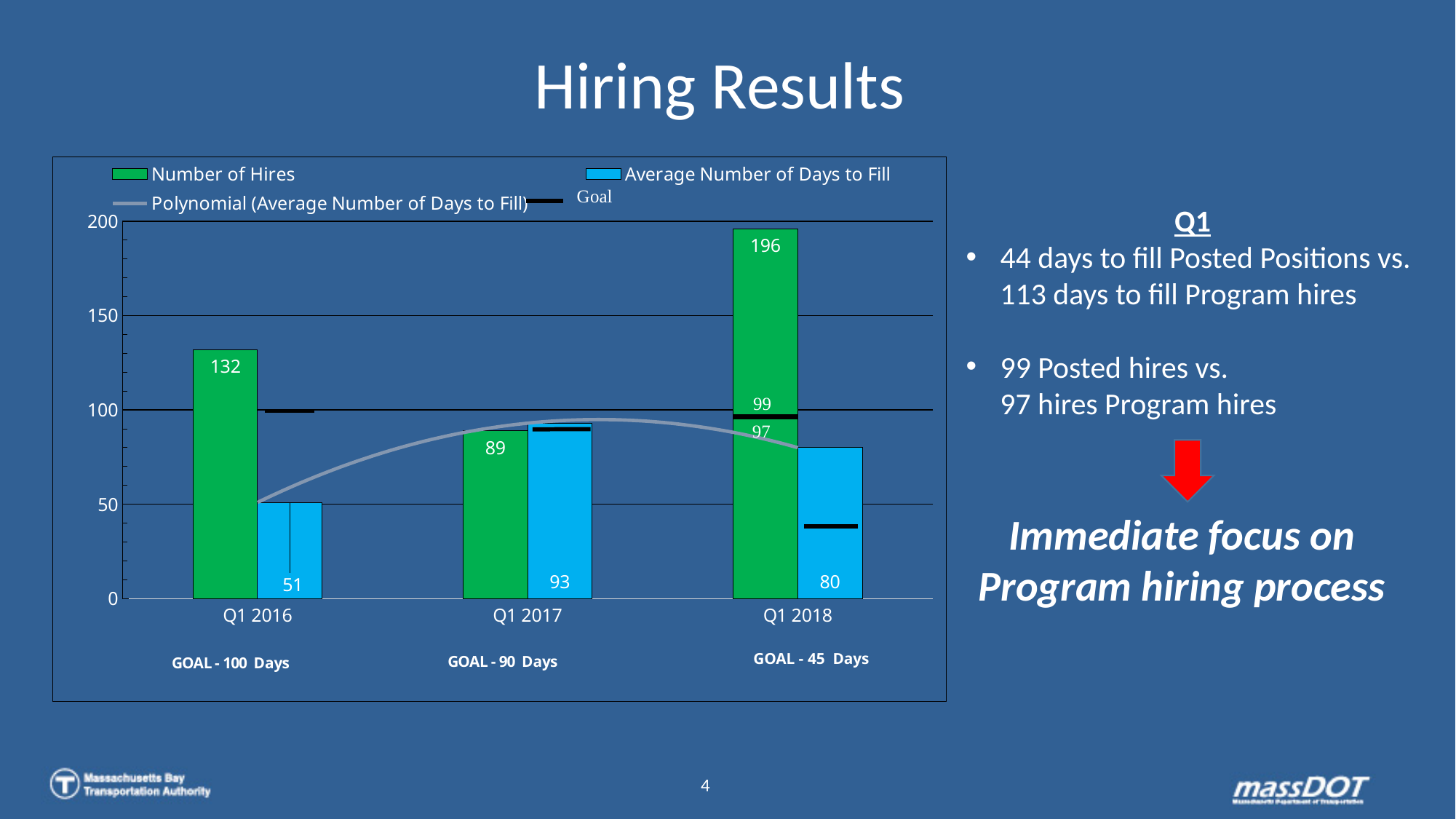
What is the Number of Hires for Q1 2018? 196 Which quarter has the lowest Average Number of Days to Fill? Q1 2016 What is the Average Number of Days to Fill for Q1 2017? 93 Which quarter has the highest Number of Hires? Q1 2018 Is the Number of Hires for Q1 2016 greater or less than 100? greater What is the Number of Hires for Q1 2016? 132 What is the goal in days shown for Q1 2018? 45 Days Which is larger for Q1 2017: the Number of Hires or the Average Number of Days to Fill? Average Number of Days to Fill What is the Average Number of Days to Fill for Q1 2018? 80 How many entries does the legend list? 4 How many quarters are shown on the x axis? 3 What is the difference in Number of Hires between Q1 2018 and Q1 2017? 107